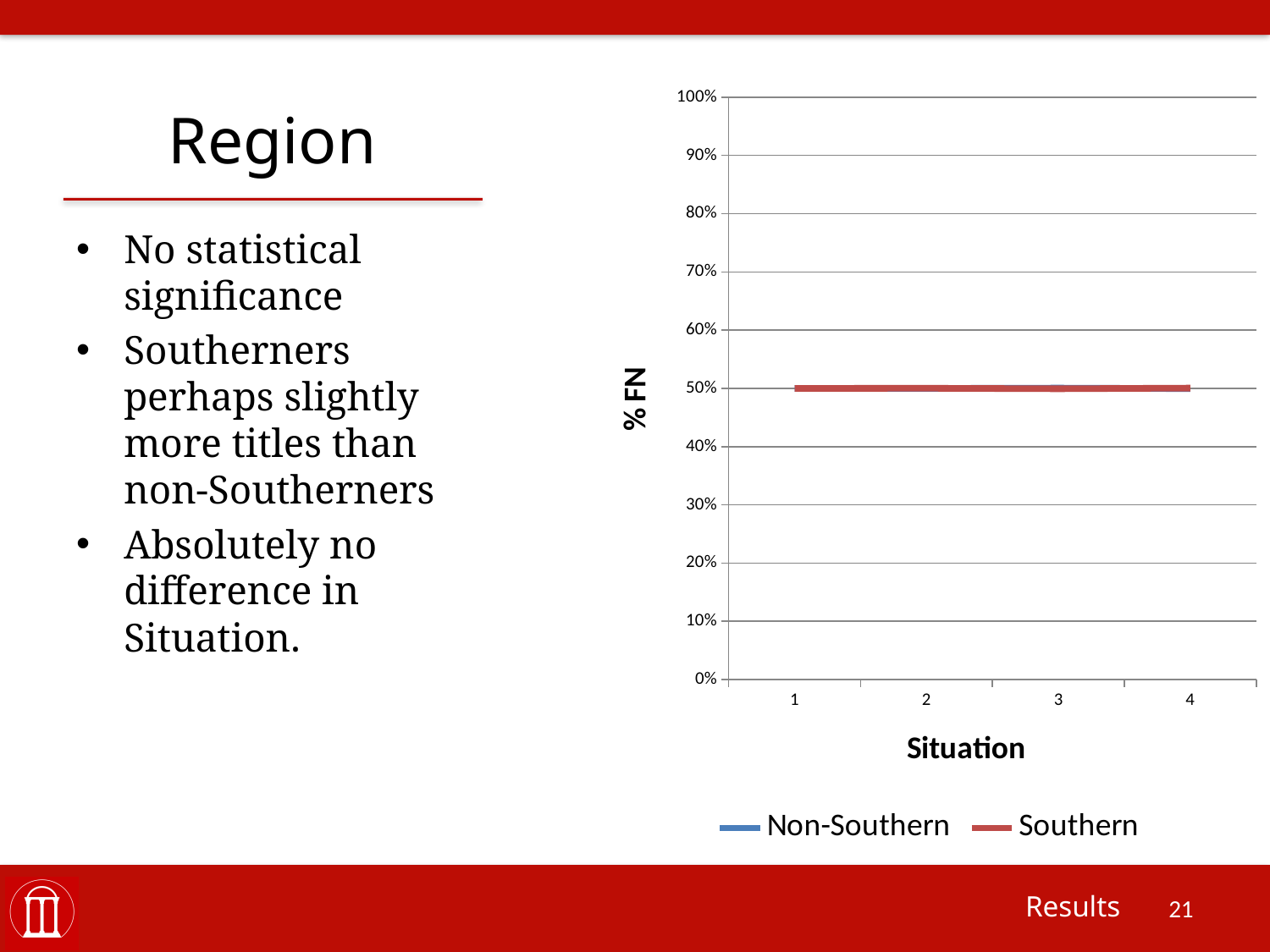
Is the value for Southern at Situation 2 greater or less than 60%? less What is the value for Southern at Situation 1? 50% What kind of chart is shown on the slide? line chart What are the two series named in the legend? Non-Southern and Southern How many situations are shown along the x axis? 4 What is the highest value shown on the y axis? 100% What is the label of the y axis? % FN Do the values for Southern rise, fall, or stay flat across Situations 1 to 4? stay flat Is the value for Non-Southern at Situation 1 greater or less than 70%? less What is the value for Southern at Situation 4? 50% How many series does the legend list? 2 Is the value for Southern at Situation 3 greater or less than 40%? greater